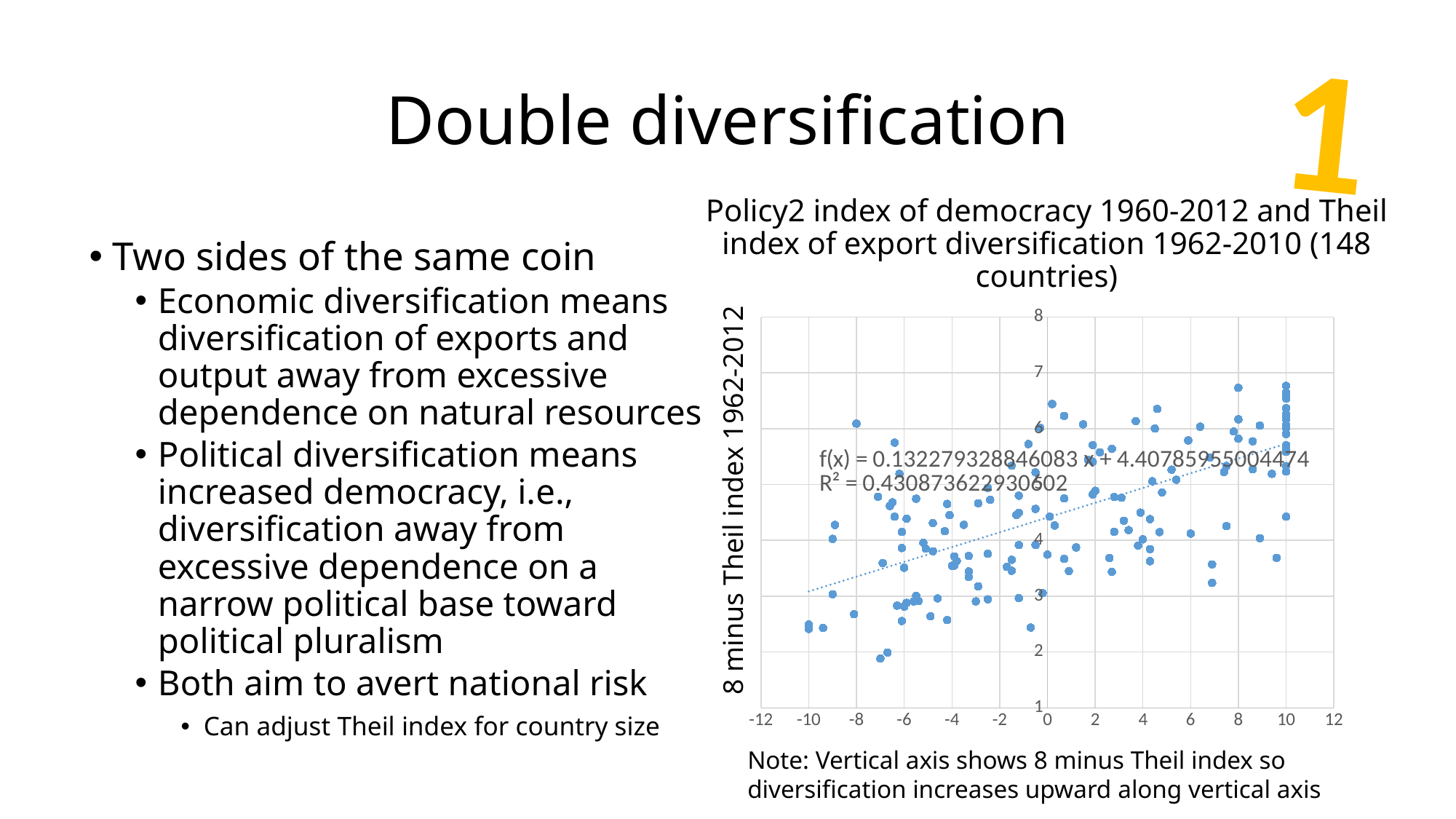
What is the slope of the fitted trendline equation printed on the chart? 0.132279328846083 Is the vertical value of the lowest plotted point greater or less than 2? less What kind of chart is shown on the slide? scatter chart Is the trendline's vertical value at x = -10 greater or less than 4? less Do the plotted values tend to rise or fall as the Policy2 index increases along the x axis? rise What is the label of the vertical axis of the chart? 8 minus Theil index 1962-2012 What is the full trendline equation printed on the chart? f(x) = 0.132279328846083 x + 4.40785955004474 What R² value is printed on the chart for the trendline? 0.430873622930602 What is the title of the chart? Policy2 index of democracy 1960-2012 and Theil index of export diversification 1962-2010 (148 countries) What is the intercept of the fitted trendline equation printed on the chart? 4.40785955004474 Is the trendline's vertical value at x = 10 greater or less than 5? greater